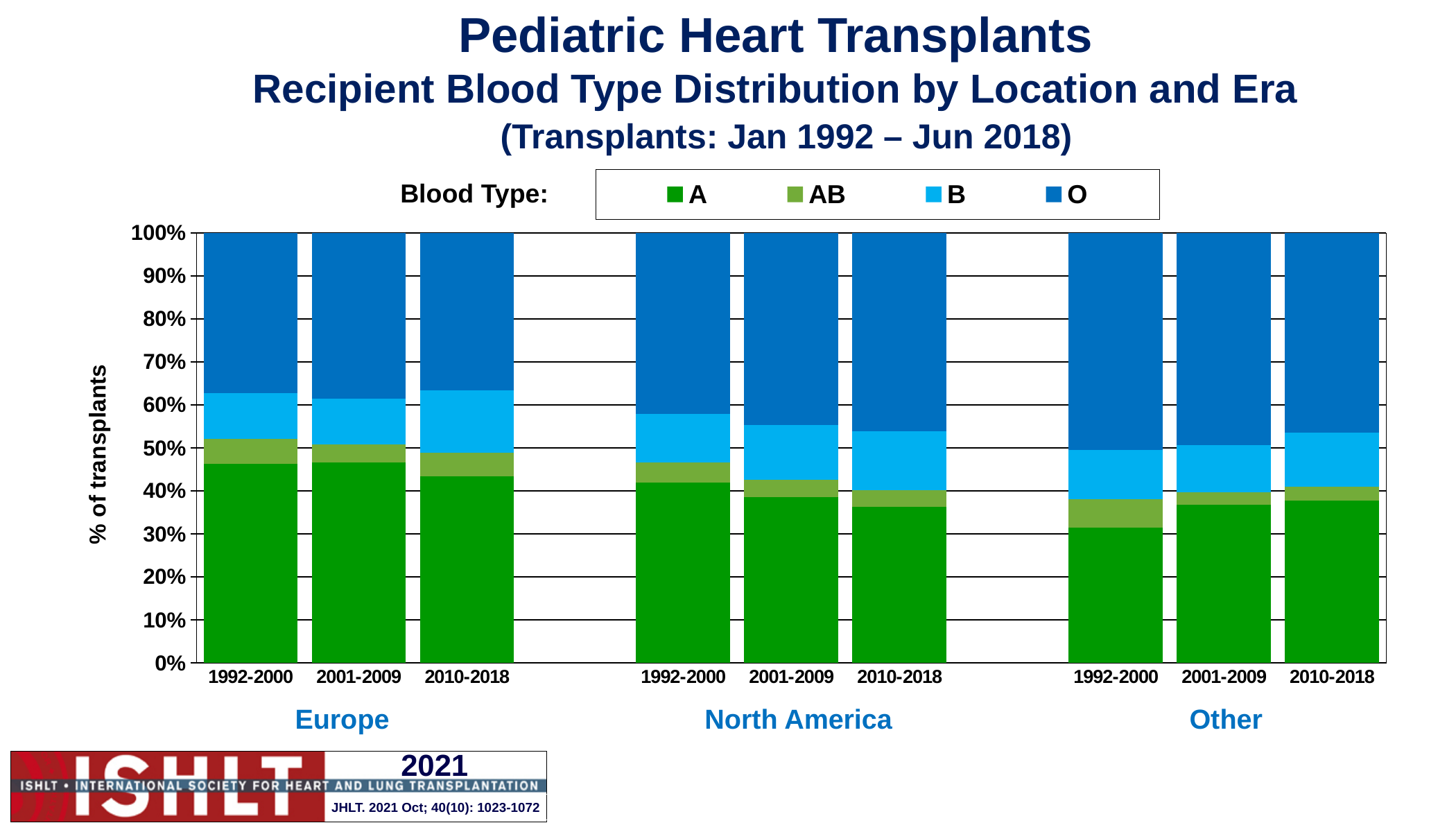
How many series does the legend list? 4 Which blood type is shown as the top segment of each stacked bar? O Is the share of blood type A recipients in North America for 2010-2018 greater or less than 40%? less How many location groups are shown along the x axis? 3 How many bars are plotted in the chart? 9 Which bar has the smallest blood type A segment? Other, 1992-2000 Which is larger: the blood type A share in Europe for 1992-2000 or in the Other region for 1992-2000? Europe, 1992-2000 What kind of chart is shown on the slide? stacked bar chart What is the label on the y axis? % of transplants Across the three eras in North America, does the share of blood type A recipients rise or fall? fall Is the share of blood type A recipients in the Other region for 1992-2000 greater or less than 40%? less Is the share of blood type A recipients in Europe for 1992-2000 greater or less than 40%? greater